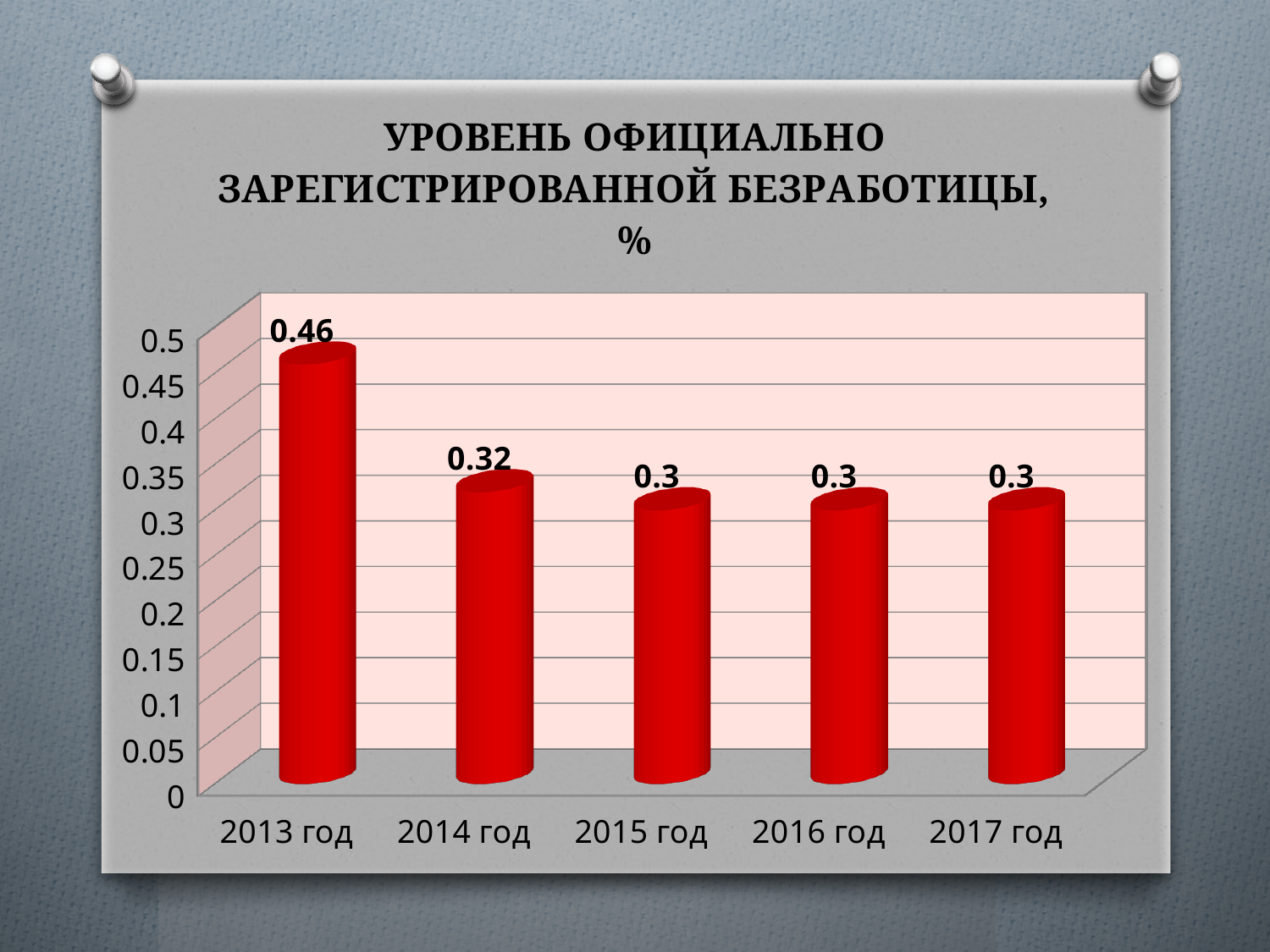
What is the difference between the values for 2014 год and 2015 год? 0.02 What is the value for 2016 год? 0.3 What is the title of the chart? УРОВЕНЬ ОФИЦИАЛЬНО ЗАРЕГИСТРИРОВАННОЙ БЕЗРАБОТИЦЫ, % Do the values rise or fall from 2013 год to 2015 год? fall What is the value for 2014 год? 0.32 How many years are shown on the x axis? 5 What is the value for 2013 год? 0.46 Which is larger, the value for 2013 год or the value for 2017 год? 2013 год What kind of chart is shown on the slide? bar chart What is the difference between the values for 2013 год and 2014 год? 0.14 Which year has the highest value? 2013 год Is the value for 2013 год greater or less than 0.4? greater